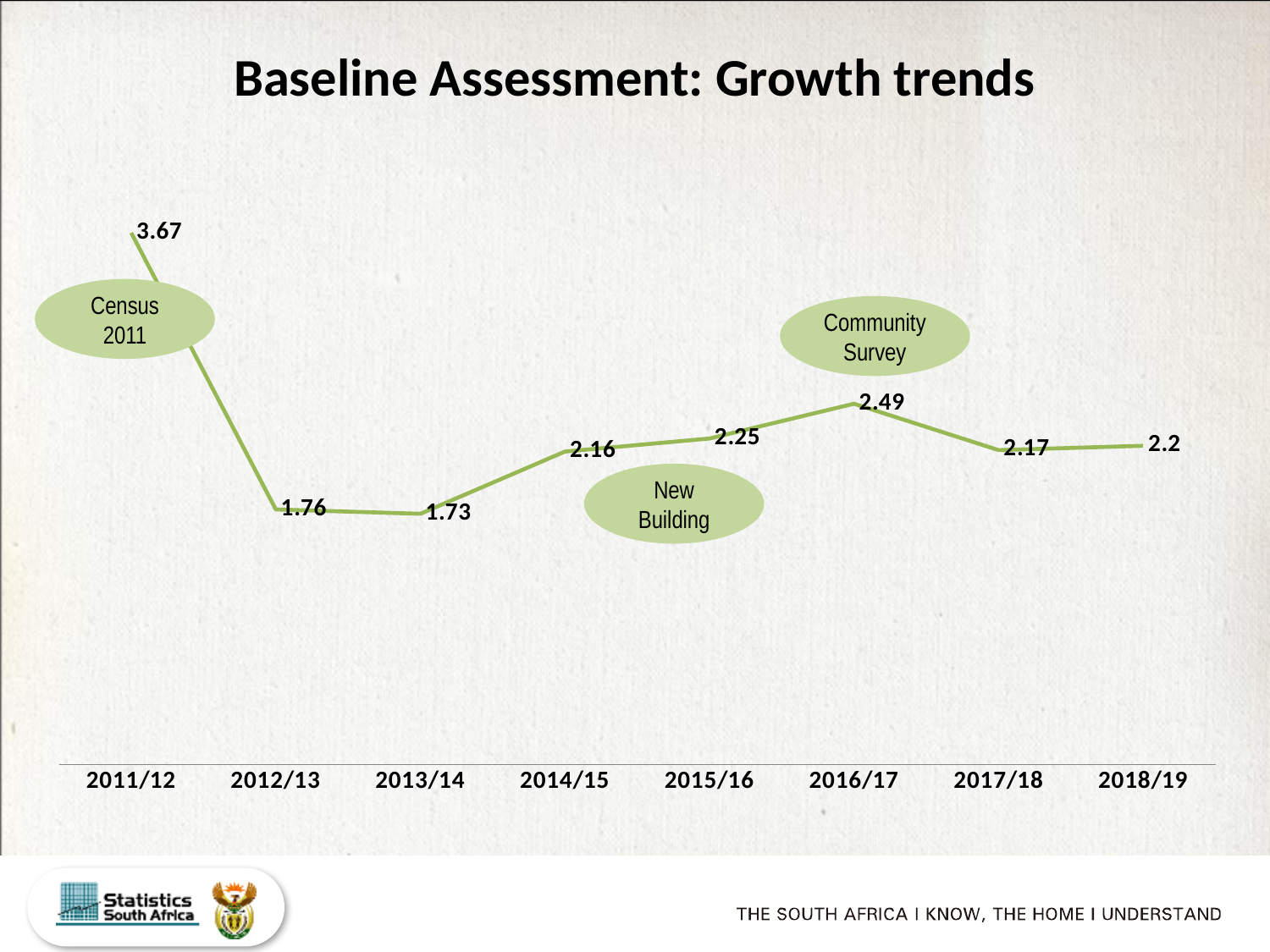
Which is larger, the value for 2014/15 or the value for 2015/16? 2015/16 Which year has the lowest value? 2013/14 What is the value for 2011/12? 3.67 What is the value for 2016/17? 2.49 What is the title of the slide? Baseline Assessment: Growth trends How many years are plotted on the x axis? 8 What is the difference between the values for 2016/17 and 2017/18? 0.32 What is the value for 2018/19? 2.2 What is the difference between the values for 2011/12 and 2012/13? 1.91 Which year has the highest value? 2011/12 What kind of chart is shown on the slide? line chart Do the values rise or fall from 2013/14 to 2016/17? rise